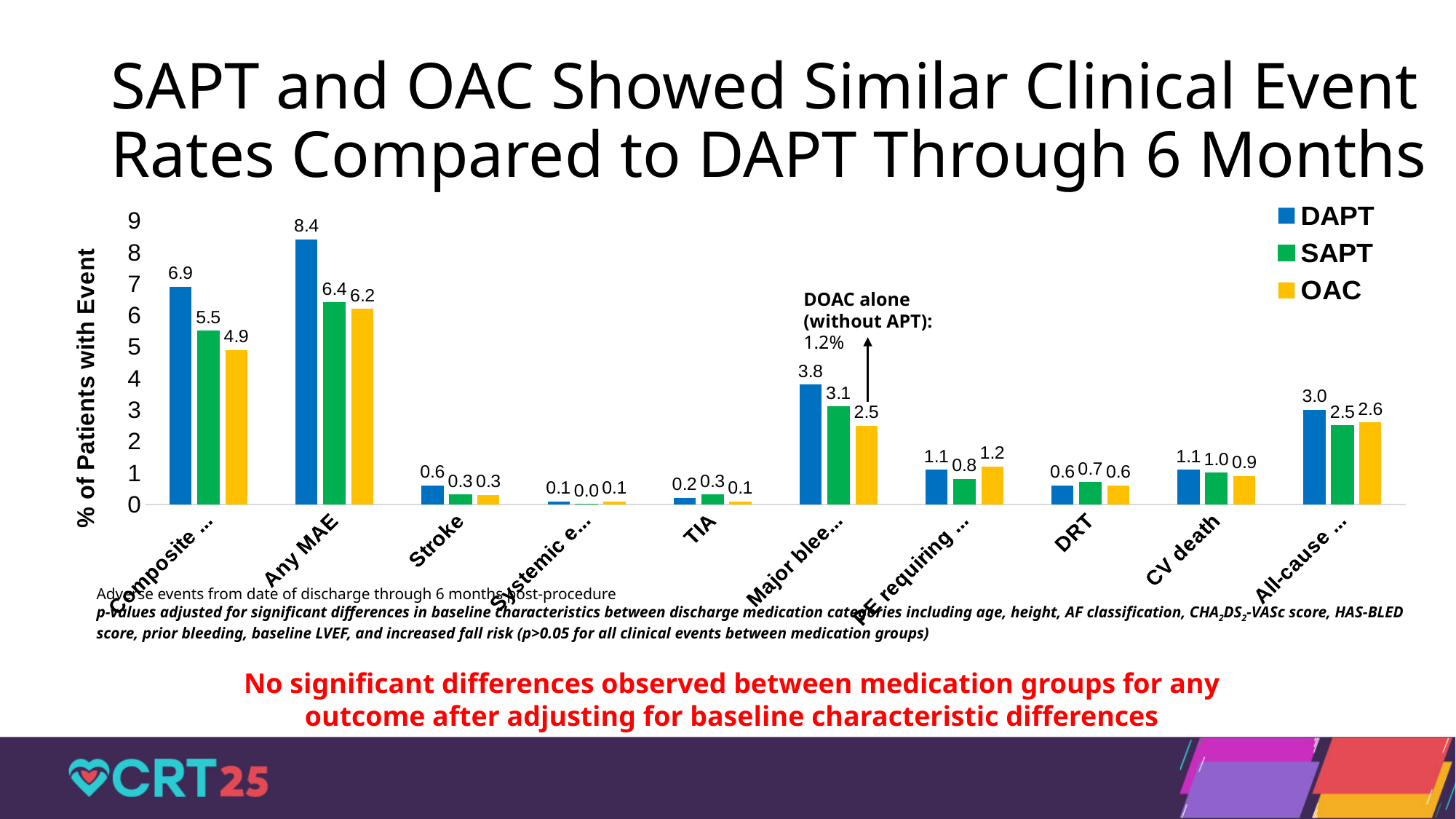
What is the OAC value for Any MAE? 6.2 What type of chart is shown on the slide? bar chart Which series has the highest value for Any MAE? DAPT What is the difference between the DAPT and SAPT values for Any MAE? 2.0 What is the DAPT value for Stroke? 0.6 How many event categories are shown along the x axis? 10 What is the label of the y axis? % of Patients with Event How many series does the legend list? 3 What is the DAPT value for Any MAE? 8.4 What is the SAPT value for CV death? 1.0 Which series has the lowest value for TIA? OAC For DRT, which is larger: the SAPT value or the OAC value? SAPT